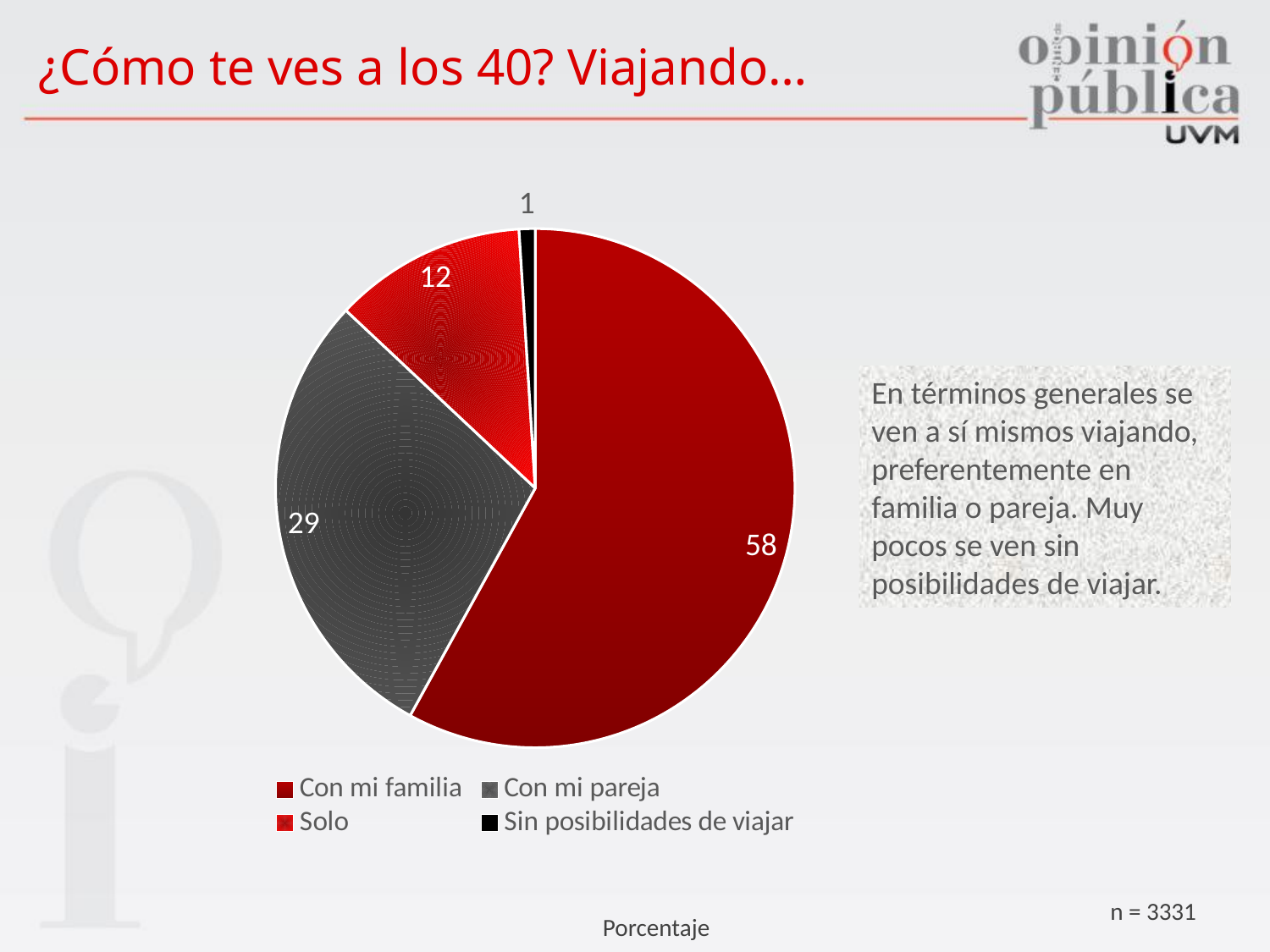
Which is larger, the value for "Solo" or the value for "Con mi pareja"? Con mi pareja How many categories does the legend list? 4 Which category has the largest slice? Con mi familia What is the title of the slide containing the chart? ¿Cómo te ves a los 40? Viajando… What is the value for "Con mi familia"? 58 What is the value for "Sin posibilidades de viajar"? 1 What is the value for "Con mi pareja"? 29 Which category has the smallest slice? Sin posibilidades de viajar What is the value for "Solo"? 12 What type of chart is shown on the slide? pie chart What is the sample size (n) shown on the slide? n = 3331 What is the difference between the values for "Con mi familia" and "Con mi pareja"? 29